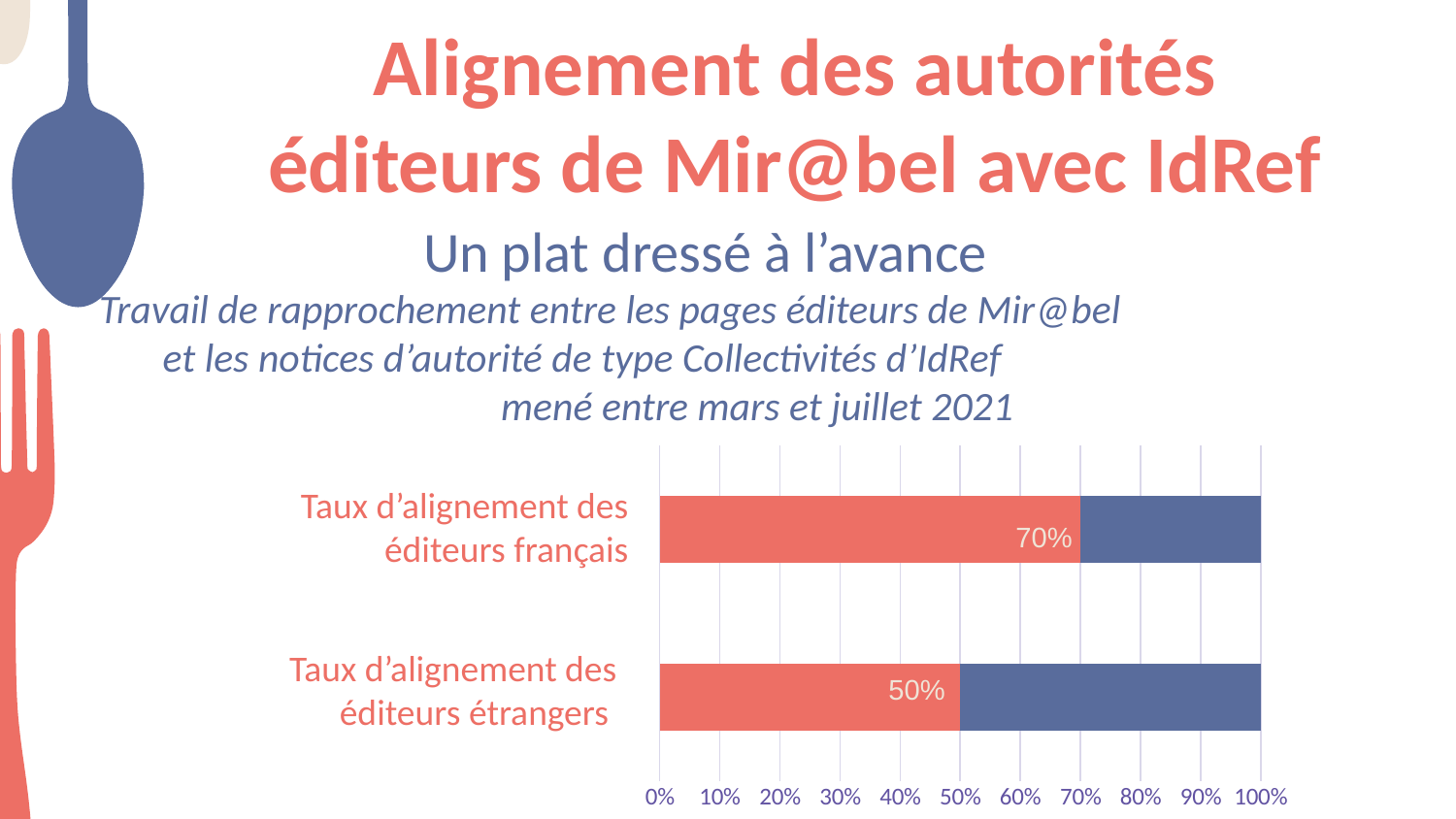
Is the labelled value for 'Taux d'alignement des éditeurs français' greater or less than 60%? greater How many categories are shown on the chart? 2 What is the difference between the labelled values for éditeurs français and éditeurs étrangers? 20 percentage points What colour are the bar segments that carry the 70% and 50% labels? red Is the labelled value for 'Taux d'alignement des éditeurs étrangers' greater or less than 40%? greater What is the labelled value for 'Taux d'alignement des éditeurs étrangers'? 50% Is the labelled value for éditeurs étrangers larger or smaller than the labelled value for éditeurs français? smaller What is the highest value shown on the horizontal axis of the chart? 100% What kind of chart is shown on the slide? bar chart What is the labelled value for 'Taux d'alignement des éditeurs français'? 70% Which category has the lower labelled alignment rate? Taux d'alignement des éditeurs étrangers Which category has the higher labelled alignment rate? Taux d'alignement des éditeurs français